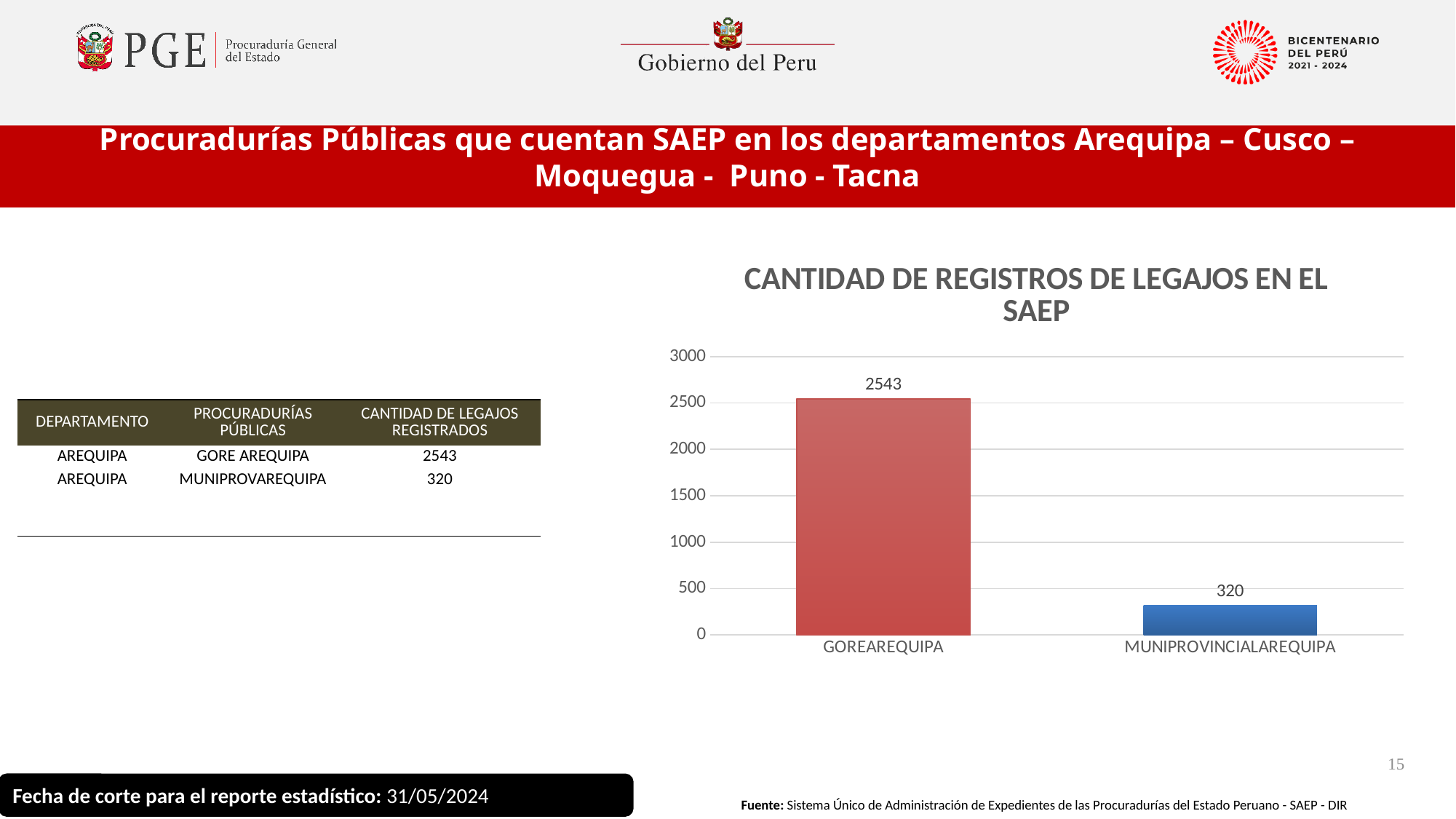
What is the difference between the values for GOREAREQUIPA and MUNIPROVINCIALAREQUIPA? 2223 Which category has the lowest value in the chart? MUNIPROVINCIALAREQUIPA What is the title of the chart? CANTIDAD DE REGISTROS DE LEGAJOS EN EL SAEP What is the highest value shown on the chart's vertical axis? 3000 Which is larger, the value for GOREAREQUIPA or the value for MUNIPROVINCIALAREQUIPA? GOREAREQUIPA Is the value for MUNIPROVINCIALAREQUIPA greater or less than 500? less Which category has the highest value in the chart? GOREAREQUIPA Is the value for GOREAREQUIPA greater or less than 2000? greater What kind of chart is shown on the slide? Bar chart How many categories are shown in the chart? 2 What is the value for MUNIPROVINCIALAREQUIPA in the chart? 320 What is the value for GOREAREQUIPA in the chart? 2543